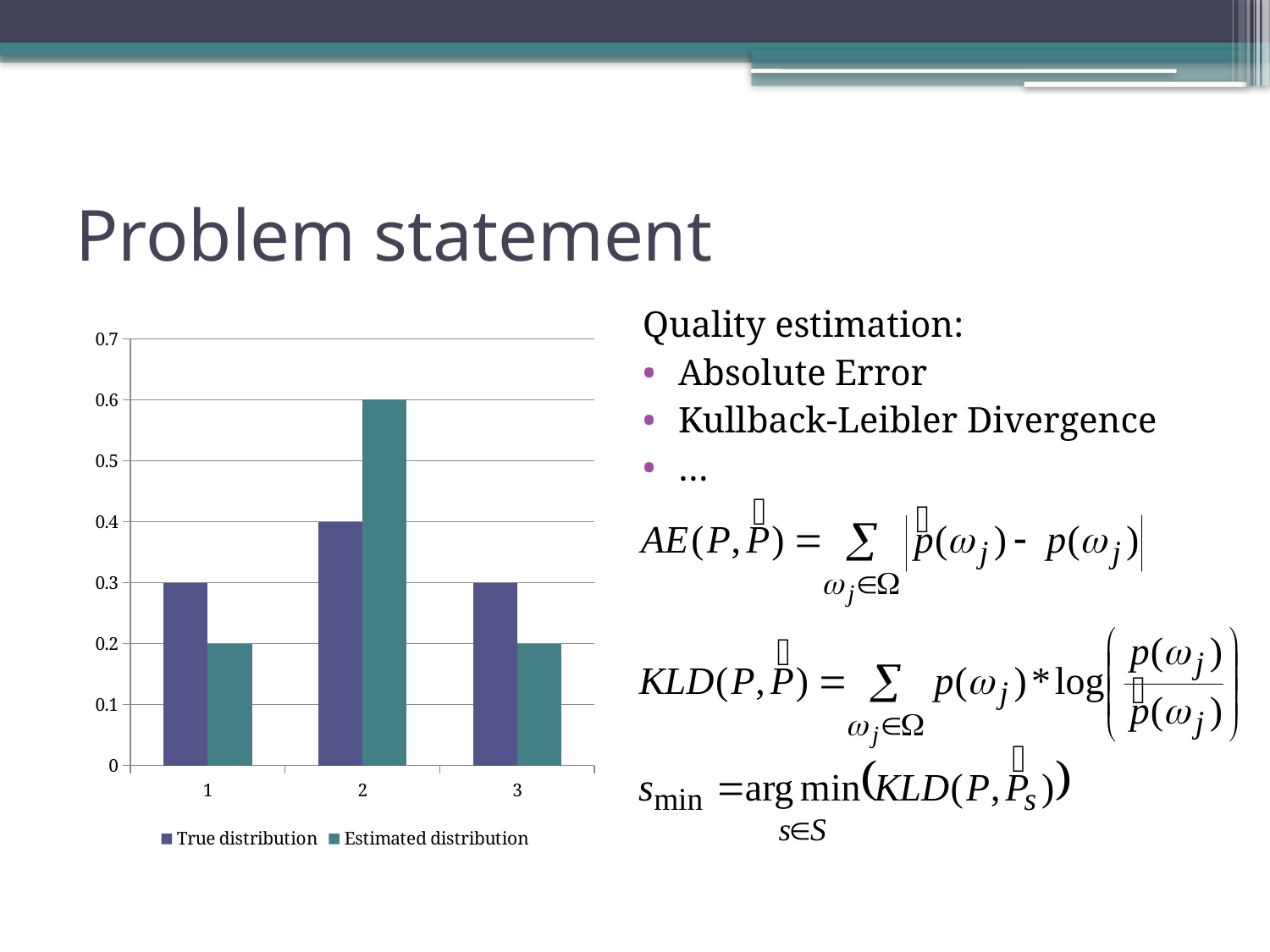
For category 1, which is larger: the True distribution or the Estimated distribution? True distribution What is the value of the True distribution for category 1? 0.3 How many series does the chart legend list? 2 What kind of chart is shown on the slide? bar chart Is the Estimated distribution value for category 2 greater or less than 0.5? greater What is the value of the Estimated distribution for category 3? 0.2 What is the difference between the Estimated distribution and the True distribution for category 2? 0.2 What is the value of the True distribution for category 2? 0.4 How many categories are shown on the x axis of the chart? 3 Which category has the highest Estimated distribution value? 2 What is the value of the Estimated distribution for category 2? 0.6 Which series is shown in teal in the chart legend? Estimated distribution